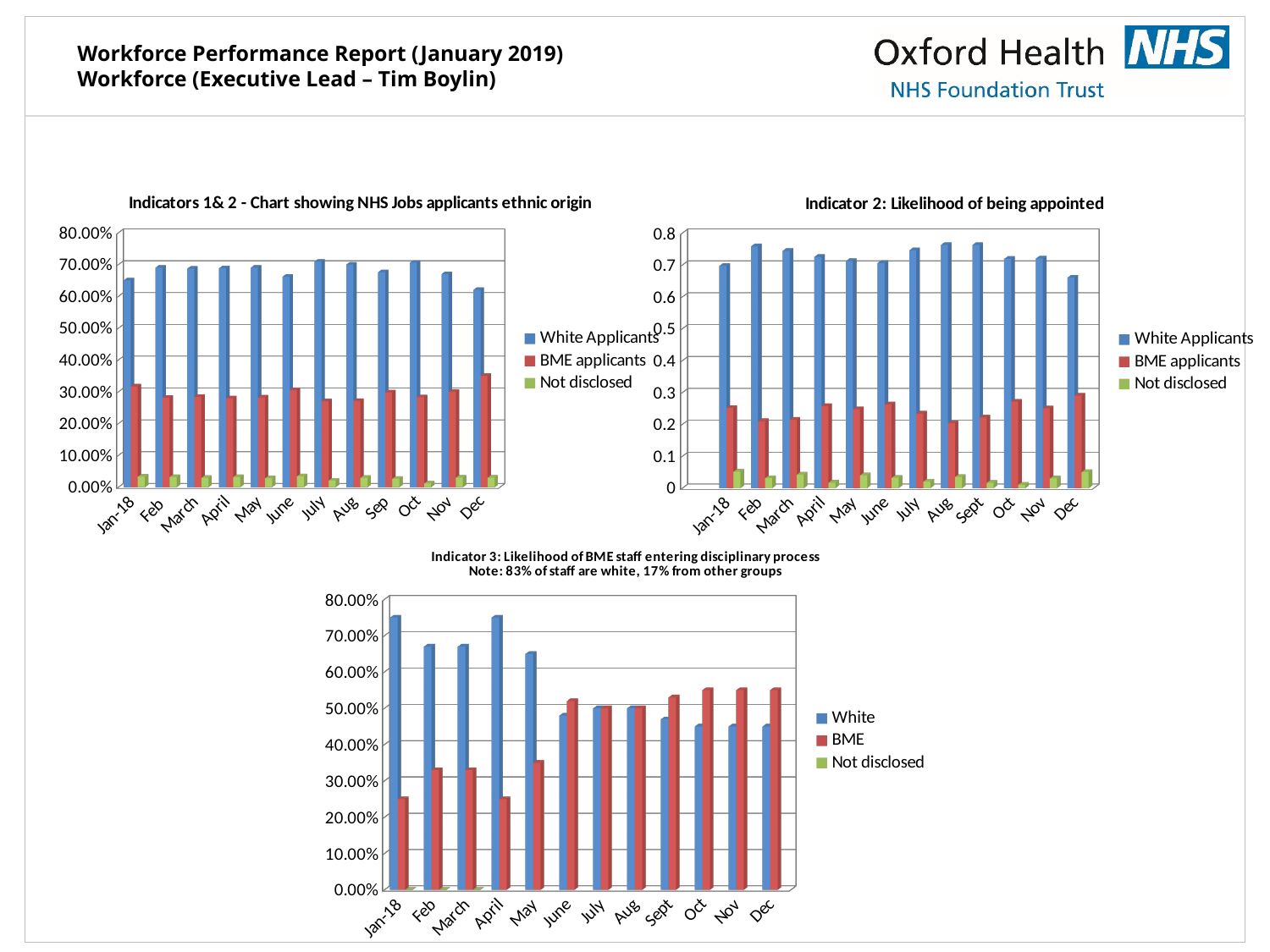
In the 'Indicator 2: Likelihood of being appointed' chart, is the value for Not disclosed in Jan-18 greater or less than 0.1? less In the 'Indicators 1& 2 - Chart showing NHS Jobs applicants ethnic origin' chart, which month has the lowest value for White Applicants? Dec In the 'Indicators 1& 2 - Chart showing NHS Jobs applicants ethnic origin' chart, which month has the highest value for BME applicants? Dec In the 'Indicator 3: Likelihood of BME staff entering disciplinary process' chart, which is larger in Dec, White or BME? BME In the 'Indicator 2: Likelihood of being appointed' chart, which month has the lowest value for White Applicants? Dec In the 'Indicator 3: Likelihood of BME staff entering disciplinary process' chart, which is larger in Jan-18, White or BME? White How many months are shown on the x axis of the 'Indicator 3: Likelihood of BME staff entering disciplinary process' chart? 12 In the 'Indicator 3: Likelihood of BME staff entering disciplinary process' chart, is the value for BME in Feb greater or less than 30.00%? greater In the 'Indicators 1& 2 - Chart showing NHS Jobs applicants ethnic origin' chart, is the value for White Applicants in Jan-18 greater or less than 60.00%? greater What kind of chart is 'Indicator 2: Likelihood of being appointed'? bar chart How many series does the legend list in the 'Indicators 1& 2 - Chart showing NHS Jobs applicants ethnic origin' chart? 3